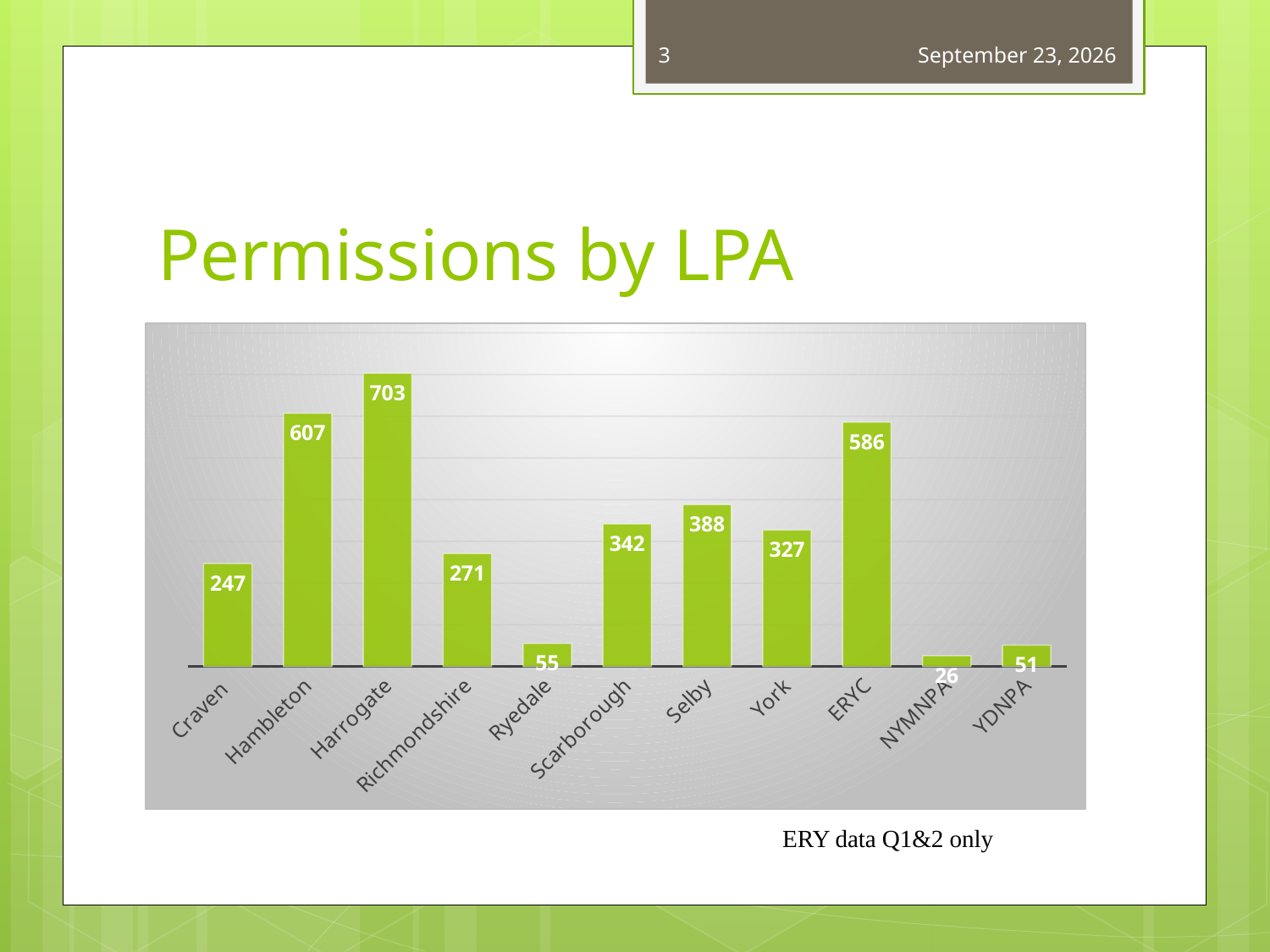
What is the value for Harrogate? 703 What is the value for Richmondshire? 271 What is the value for NYMNPA? 26 How many LPAs are shown on the chart? 11 What is the difference between the values for Hambleton and Craven? 360 What is the title of the slide containing the chart? Permissions by LPA What is the difference between the values for YDNPA and Ryedale? 4 What is the value for ERYC? 586 Which LPA has the highest number of permissions? Harrogate Which is larger, the value for Selby or the value for York? Selby Which LPA has the lowest number of permissions? NYMNPA What kind of chart is shown on the slide? Bar chart